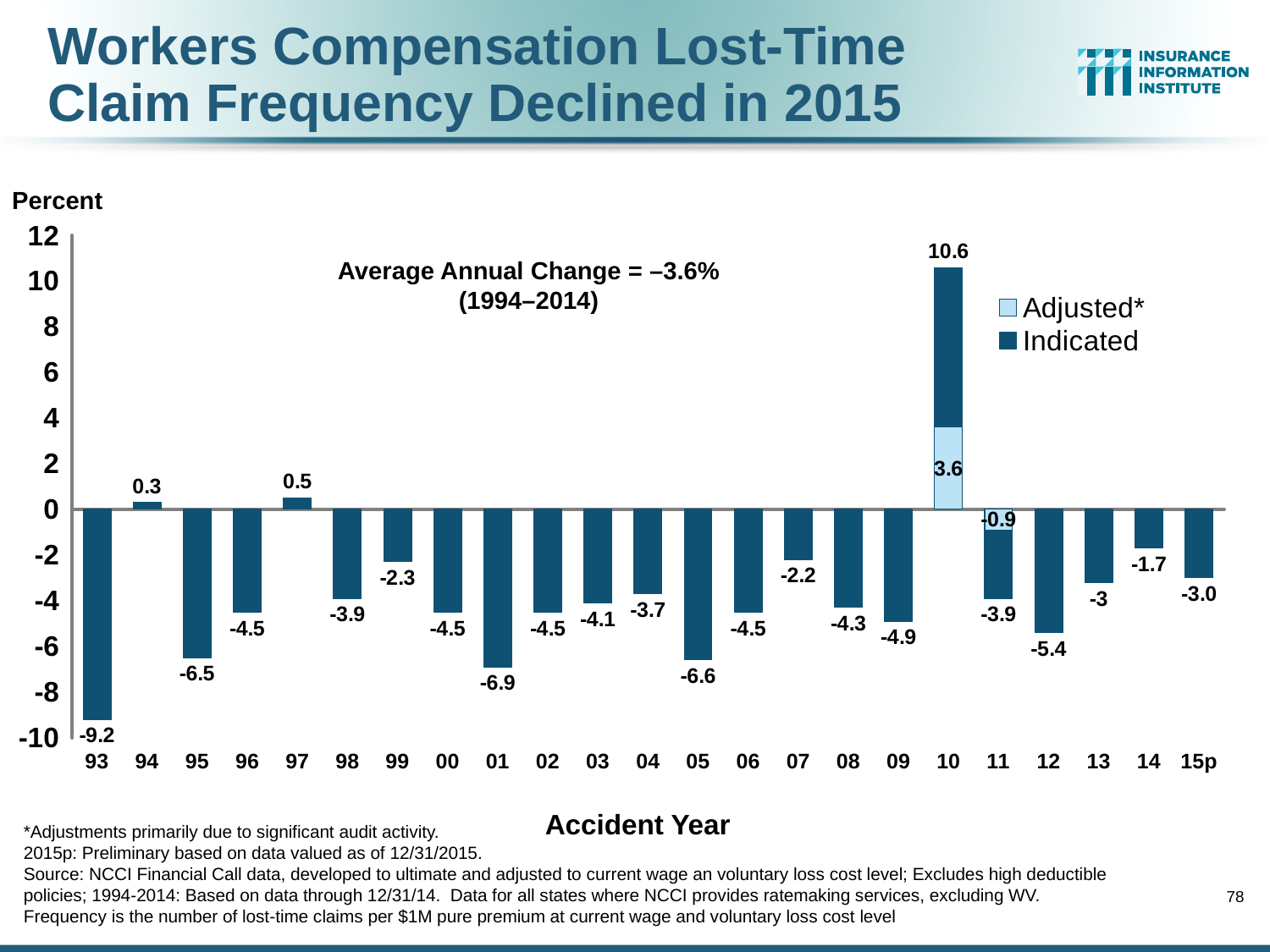
What is the Indicated value for accident year 10? 10.6 What kind of chart is shown on the slide? Bar chart Which is larger, the value for accident year 94 or accident year 97? 97 What is the value for accident year 93? -9.2 How many accident years are shown on the x axis? 23 Which accident year has the lowest value? 93 What is the difference between the values for accident years 01 and 05? 0.3 How many series does the legend list? 2 What is the value for accident year 14? -1.7 What is the Adjusted value for accident year 10? 3.6 What is the value for accident year 15p? -3.0 Which accident year has the highest value? 10